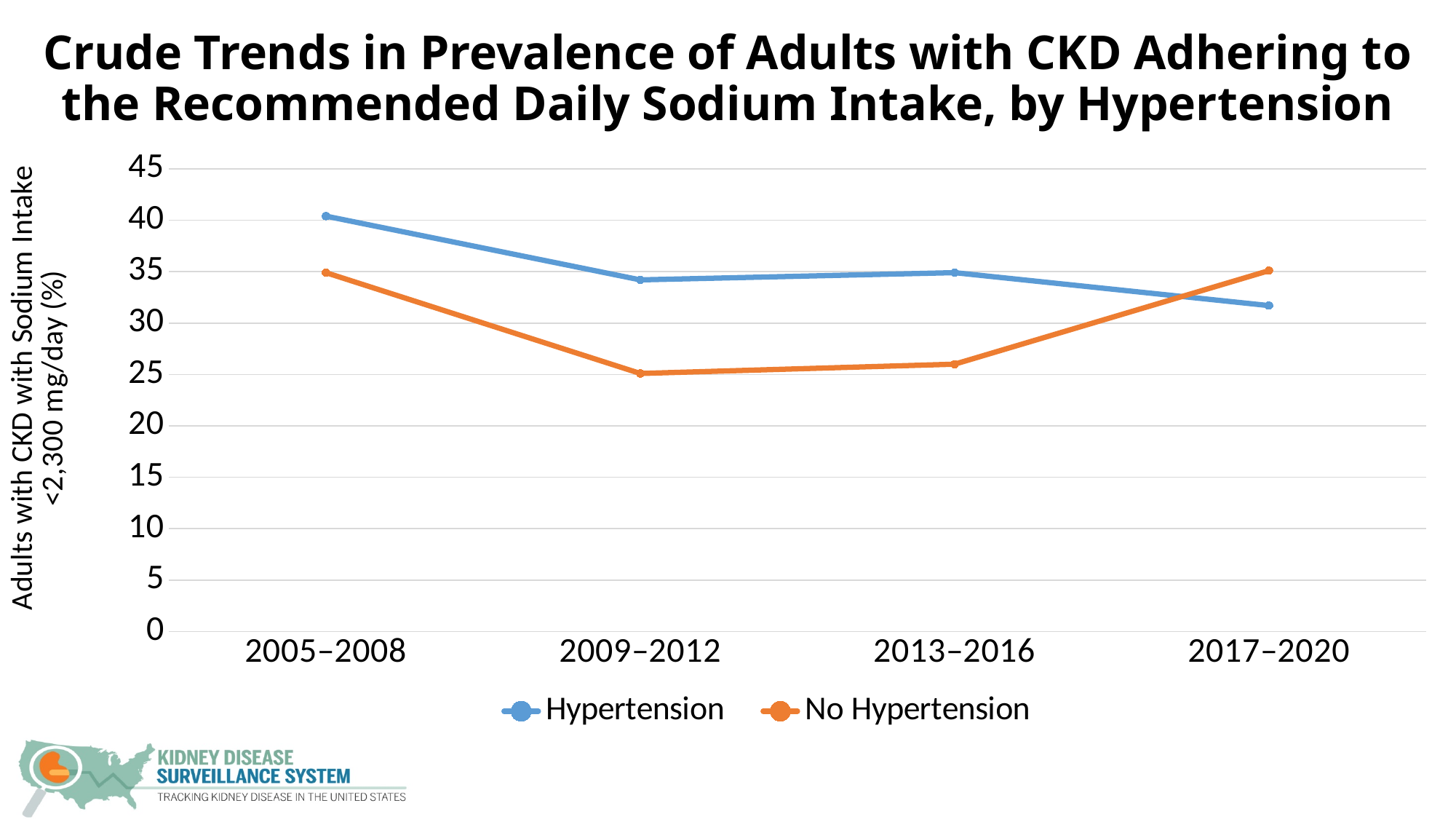
In which period is the Hypertension series lowest? 2017–2020 In which period is the Hypertension series highest? 2005–2008 What kind of chart is shown on the slide? line chart In 2009–2012, which series has the larger value, Hypertension or No Hypertension? Hypertension How many time periods are plotted on the x axis? 4 Is the value for No Hypertension in 2013–2016 greater or less than 30? less How many series does the legend list? 2 In 2017–2020, which series has the larger value, Hypertension or No Hypertension? No Hypertension Does the Hypertension series rise or fall from 2013–2016 to 2017–2020? fall Which colour represents the No Hypertension series? orange In which period is the No Hypertension series lowest? 2009–2012